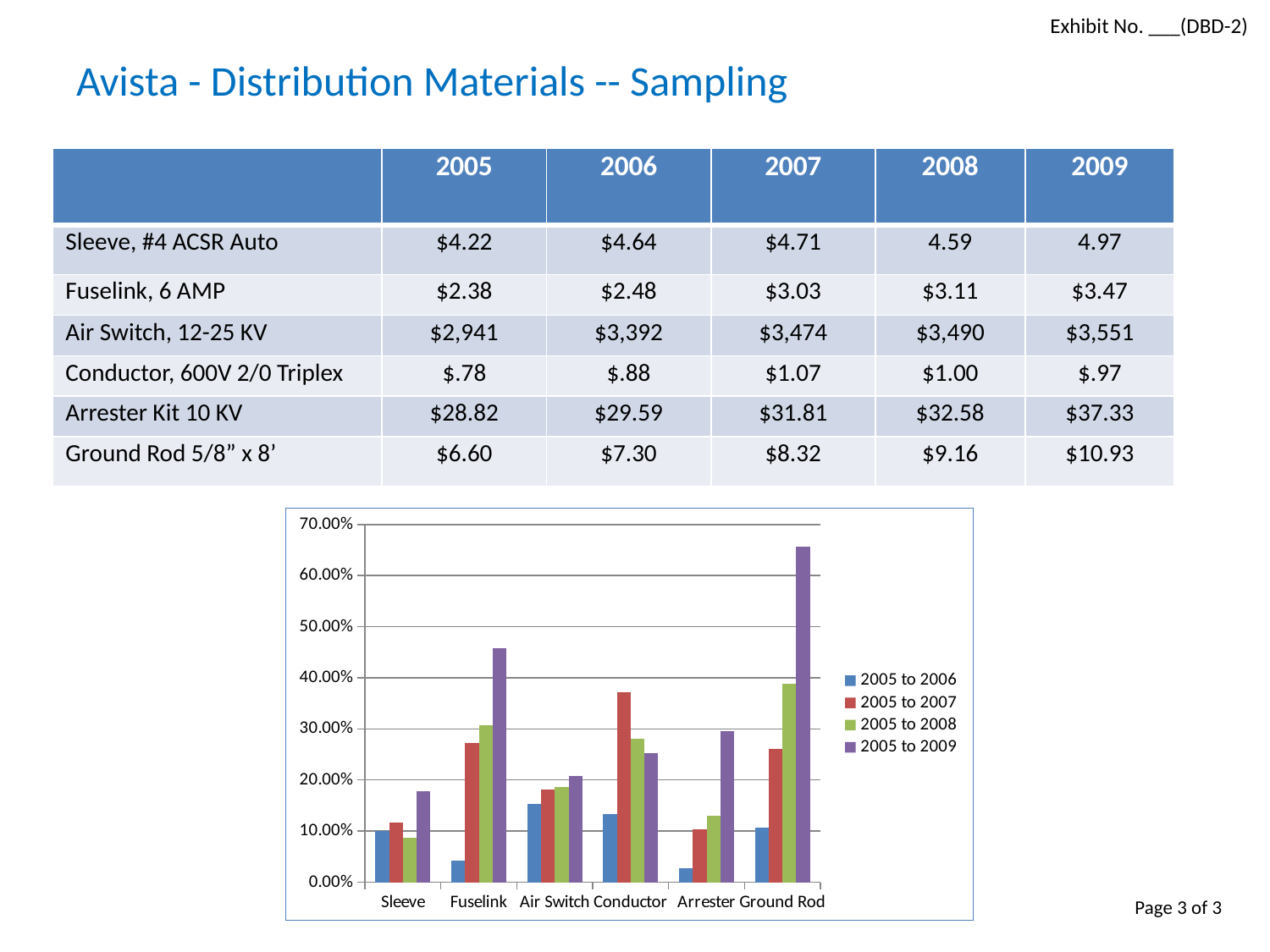
What kind of chart is shown on the slide? Bar chart Is the 2005 to 2009 value for Fuselink greater or less than 40.00%? greater Is the 2005 to 2006 value for Arrester greater or less than 10.00%? less For the 2005 to 2006 series, which is larger: Fuselink or Air Switch? Air Switch Which category has the highest bar for the 2005 to 2007 series? Conductor What are the four entries listed in the chart's legend? 2005 to 2006, 2005 to 2007, 2005 to 2008, 2005 to 2009 How many categories are shown along the x axis of the chart? 6 Which category has the lowest bar for the 2005 to 2006 series? Arrester For Conductor, which is larger: the 2005 to 2007 bar or the 2005 to 2008 bar? 2005 to 2007 Is the 2005 to 2009 value for Ground Rod greater or less than 60.00%? greater How many series does the chart's legend list? 4 Which category has the highest bar for the 2005 to 2009 series? Ground Rod